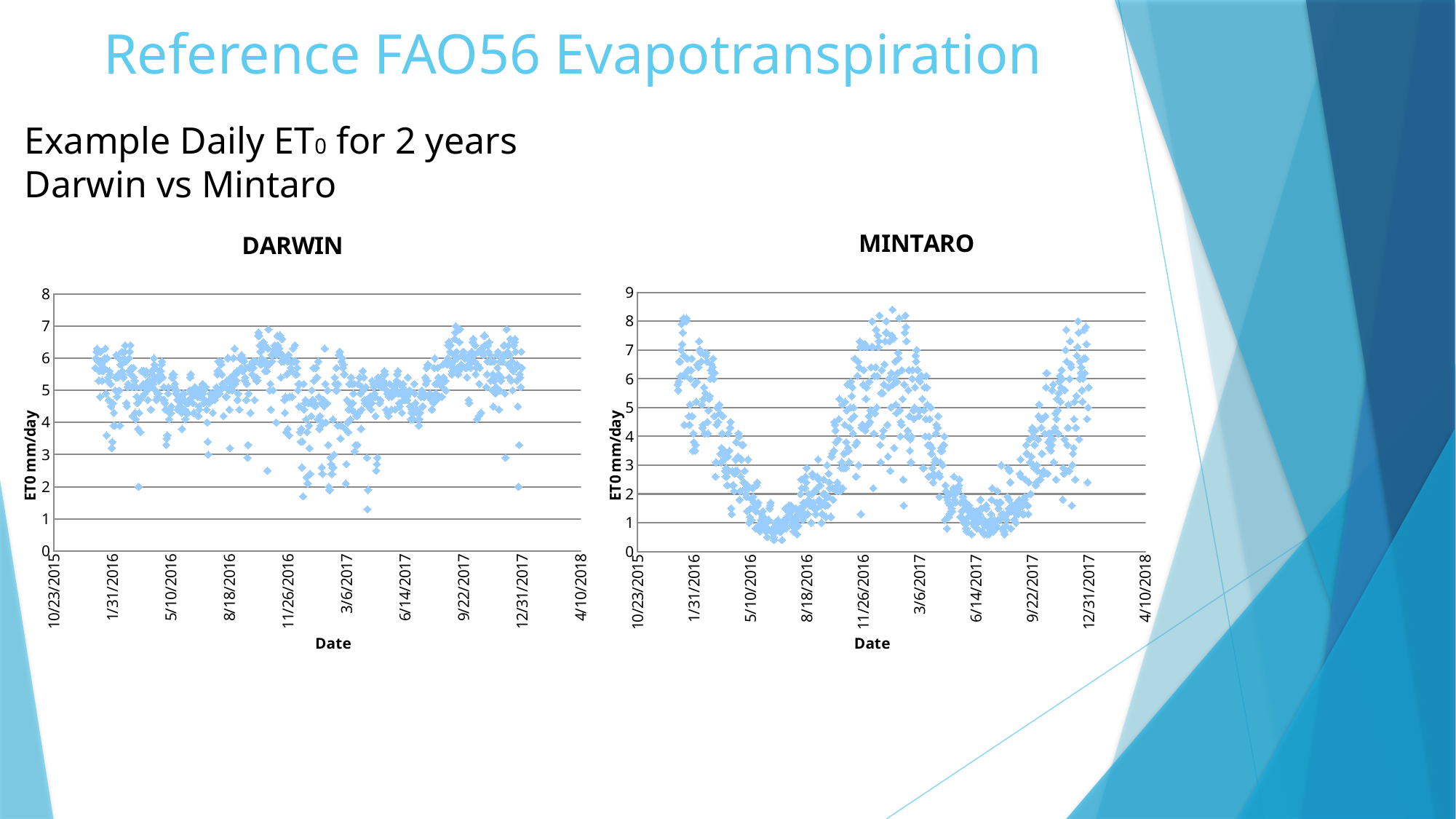
On the MINTARO chart, are the values around 6/14/2017 greater or less than 3? less What kind of chart is the MINTARO chart? scatter chart On the MINTARO chart, what is the highest value shown on the y-axis? 9 On the DARWIN chart, what is the highest value shown on the y-axis? 8 On the MINTARO chart, do the values rise or fall between 1/31/2016 and 5/10/2016? fall On the DARWIN chart, are the values around 9/22/2017 greater or less than 4? greater On the MINTARO chart, do the values rise or fall between 6/14/2017 and 12/31/2017? rise How many charts are shown on the slide? 2 What is the x-axis label on the MINTARO chart? Date What kind of chart is the DARWIN chart? scatter chart What is the y-axis label on the DARWIN chart? ET0 mm/day